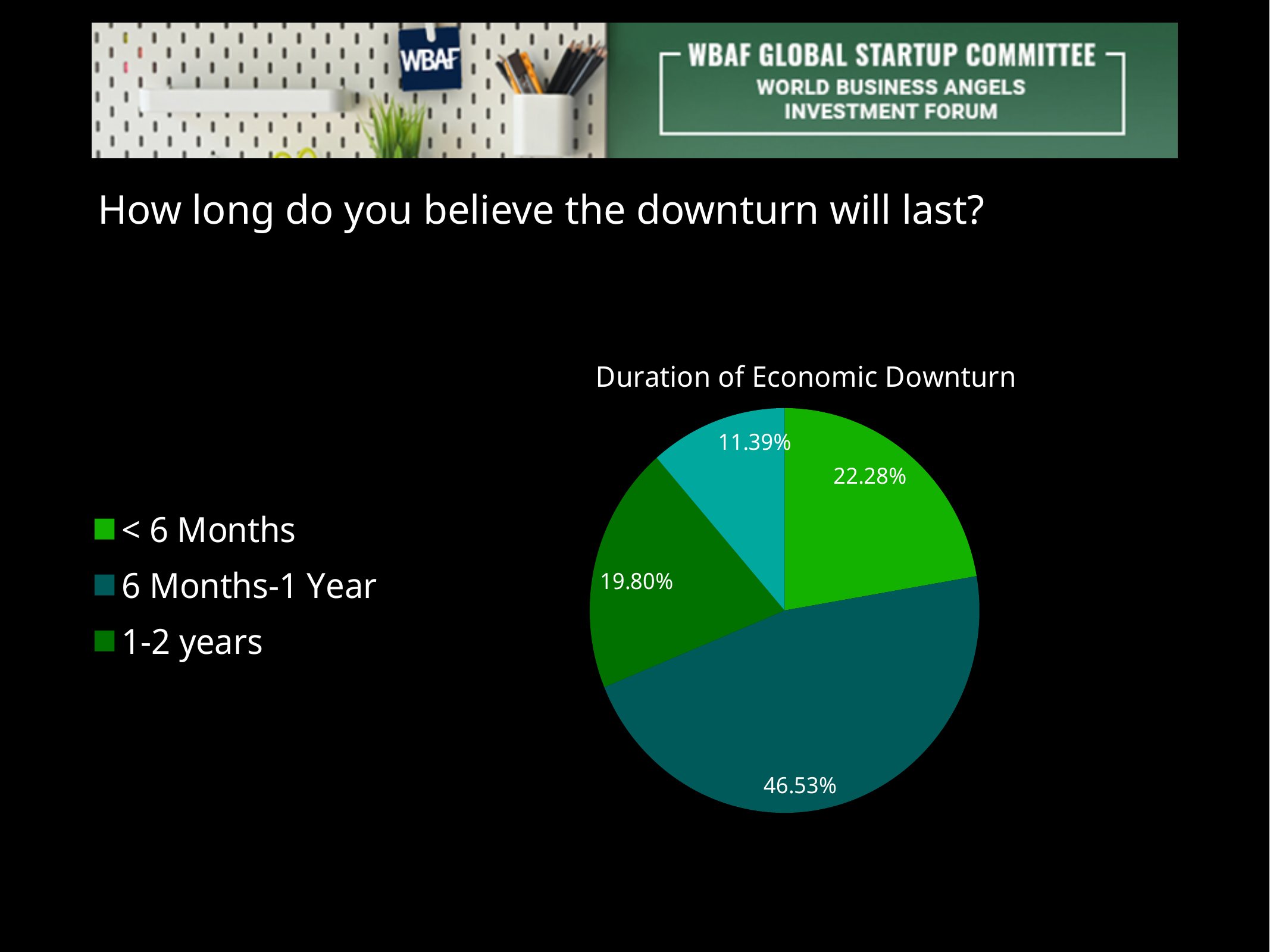
Which is larger: the share for < 6 Months or the share for 1-2 years? < 6 Months What is the smallest percentage shown on the pie chart? 11.39% What is the difference between the share for 6 Months-1 Year and the share for < 6 Months? 24.25% How many entries does the legend list? 3 What percentage of respondents believe the downturn will last less than 6 Months? 22.28% What is the difference between the share for < 6 Months and the share for 1-2 years? 2.48% Which category has the largest share of the pie? 6 Months-1 Year What percentage of respondents believe the downturn will last 6 Months-1 Year? 46.53% What percentage of respondents believe the downturn will last 1-2 years? 19.80% What is the title of the chart? Duration of Economic Downturn What type of chart is shown on the slide? pie chart How many slices does the pie chart have? 4